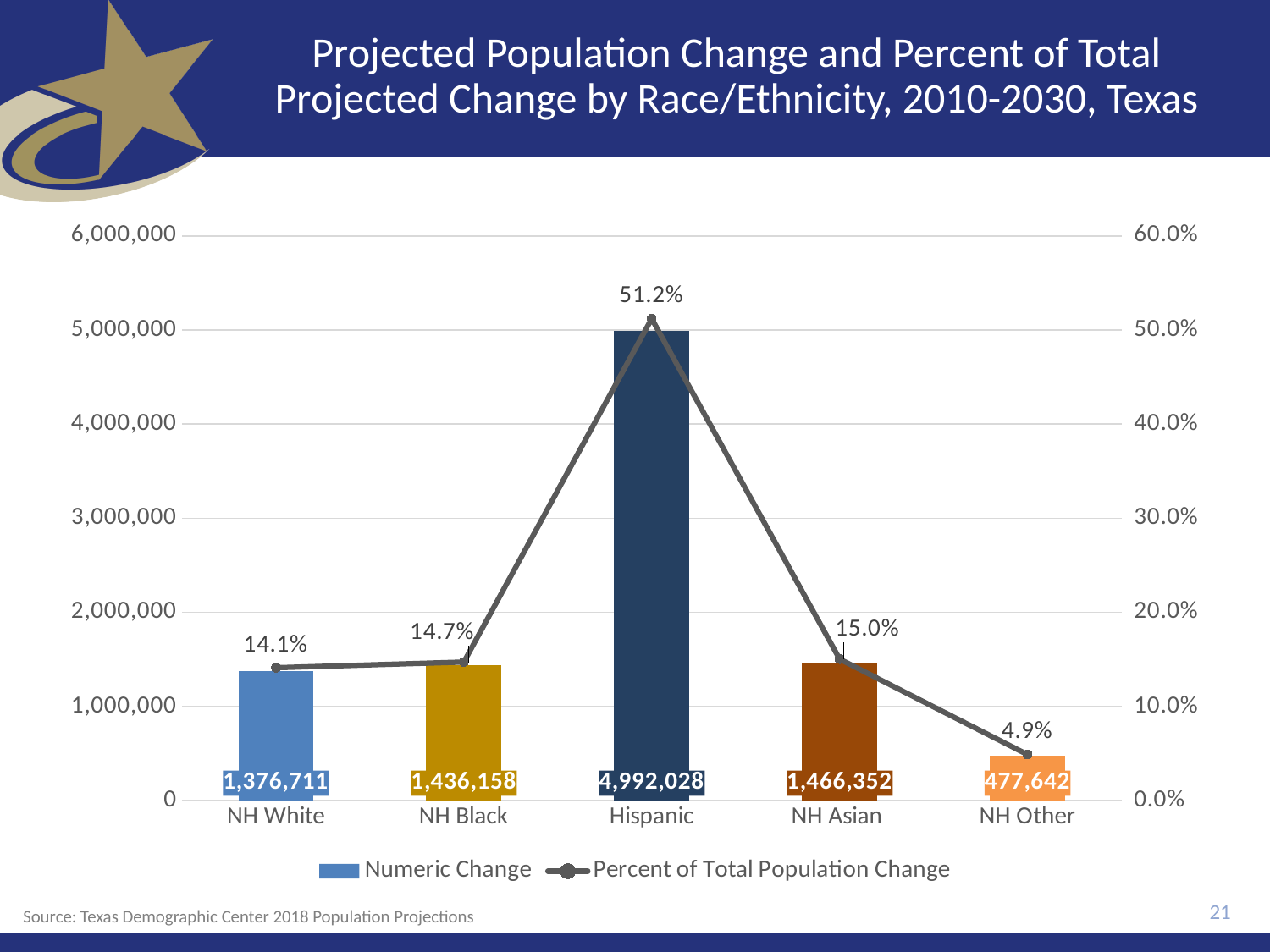
Which has a larger Numeric Change, NH Asian or NH Black? NH Asian How many series does the legend list? 2 Is the Numeric Change for Hispanic greater or less than 4,000,000? greater What is the difference in Numeric Change between NH Black and NH White? 59,447 Which race/ethnicity group has the lowest Percent of Total Population Change? NH Other How many race/ethnicity categories are shown on the x axis? 5 What is the Percent of Total Population Change for NH White? 14.1% What is the Numeric Change value for NH Other? 477,642 What is the Numeric Change value for Hispanic? 4,992,028 What kind of chart is used to show the Numeric Change series? Bar chart Which race/ethnicity group has the highest Numeric Change? Hispanic What is the Percent of Total Population Change for NH Asian? 15.0%